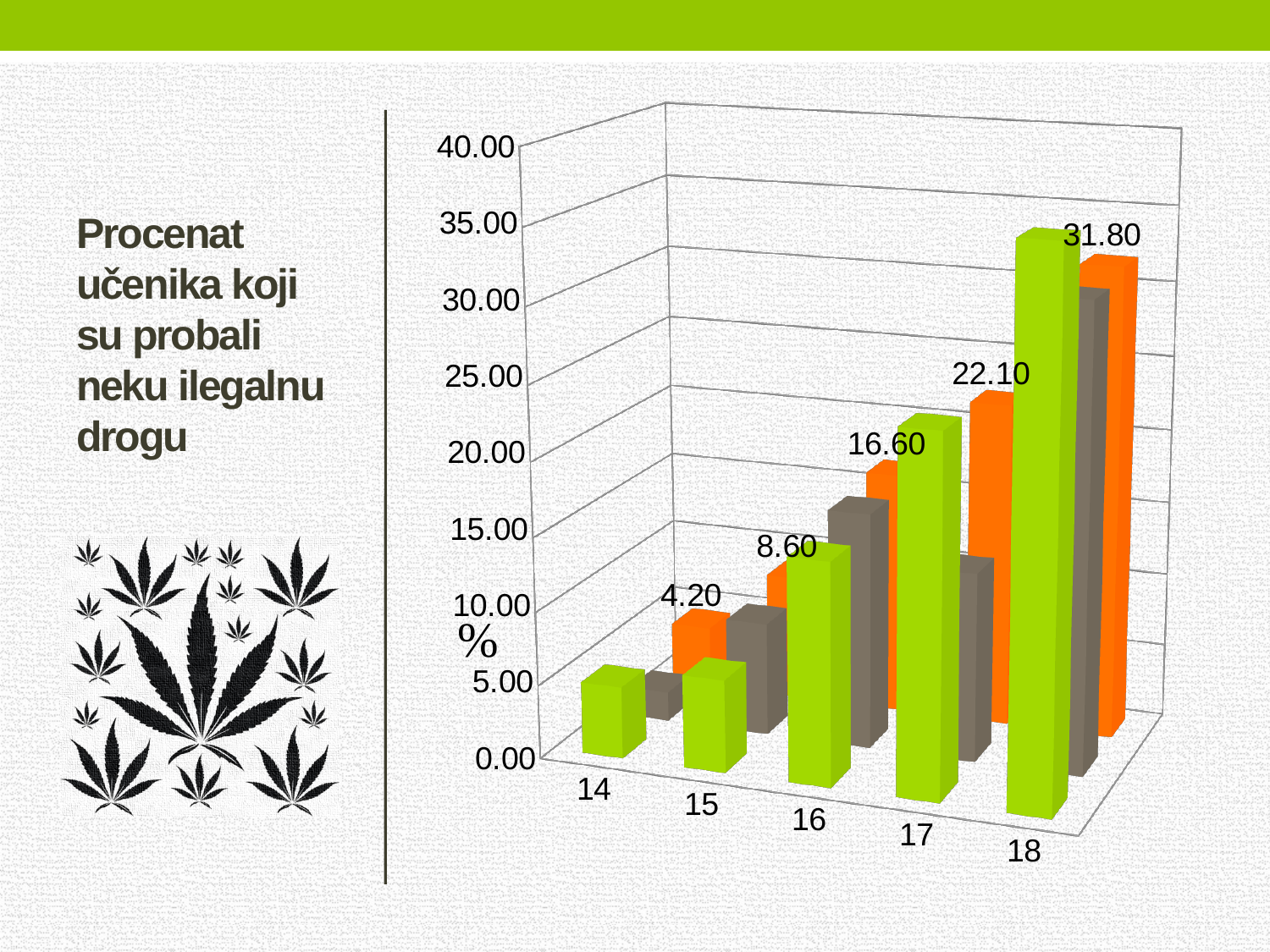
What kind of chart is shown on the slide? bar chart What is the data label on the orange bar for category 17? 22.10 Which category has the lowest bars in the chart? 14 What is the data label on the orange bar for category 18? 31.80 Is the value of the green bar for category 18 greater or less than 20.00? greater Do the values rise or fall as the categories go from 14 to 18? rise What is the data label on the orange bar for category 16? 16.60 What is the data label on the orange bar for category 14? 4.20 How many categories are shown on the x axis of the chart? 5 What is the difference between the labelled orange values for categories 18 and 14? 27.60 What is the title text shown to the left of the chart? Procenat učenika koji su probali neku ilegalnu drogu Which category has the highest bars in the chart? 18